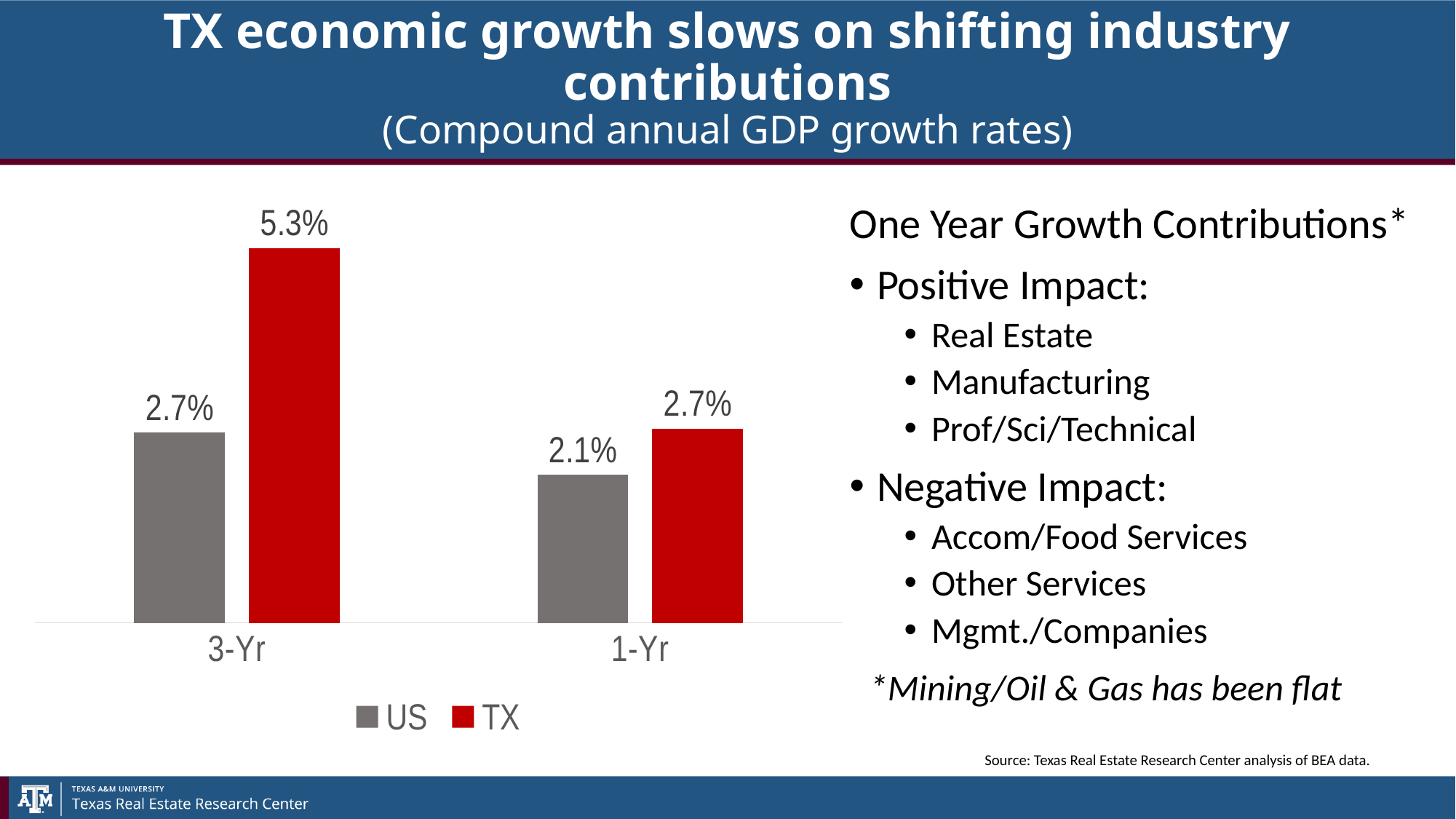
What is the US value for 3-Yr? 2.7% How many series does the legend list? 2 What is the difference between the TX and US values for 1-Yr? 0.6% What is the TX value for 3-Yr? 5.3% How many categories are shown on the x axis? 2 Which is larger for 1-Yr, US or TX? TX Which bar is the highest on the chart? TX, 3-Yr What is the difference between the TX and US values for 3-Yr? 2.6% What kind of chart is shown on the slide? Bar chart Which bar is the lowest on the chart? US, 1-Yr What is the US value for 1-Yr? 2.1% What is the TX value for 1-Yr? 2.7%